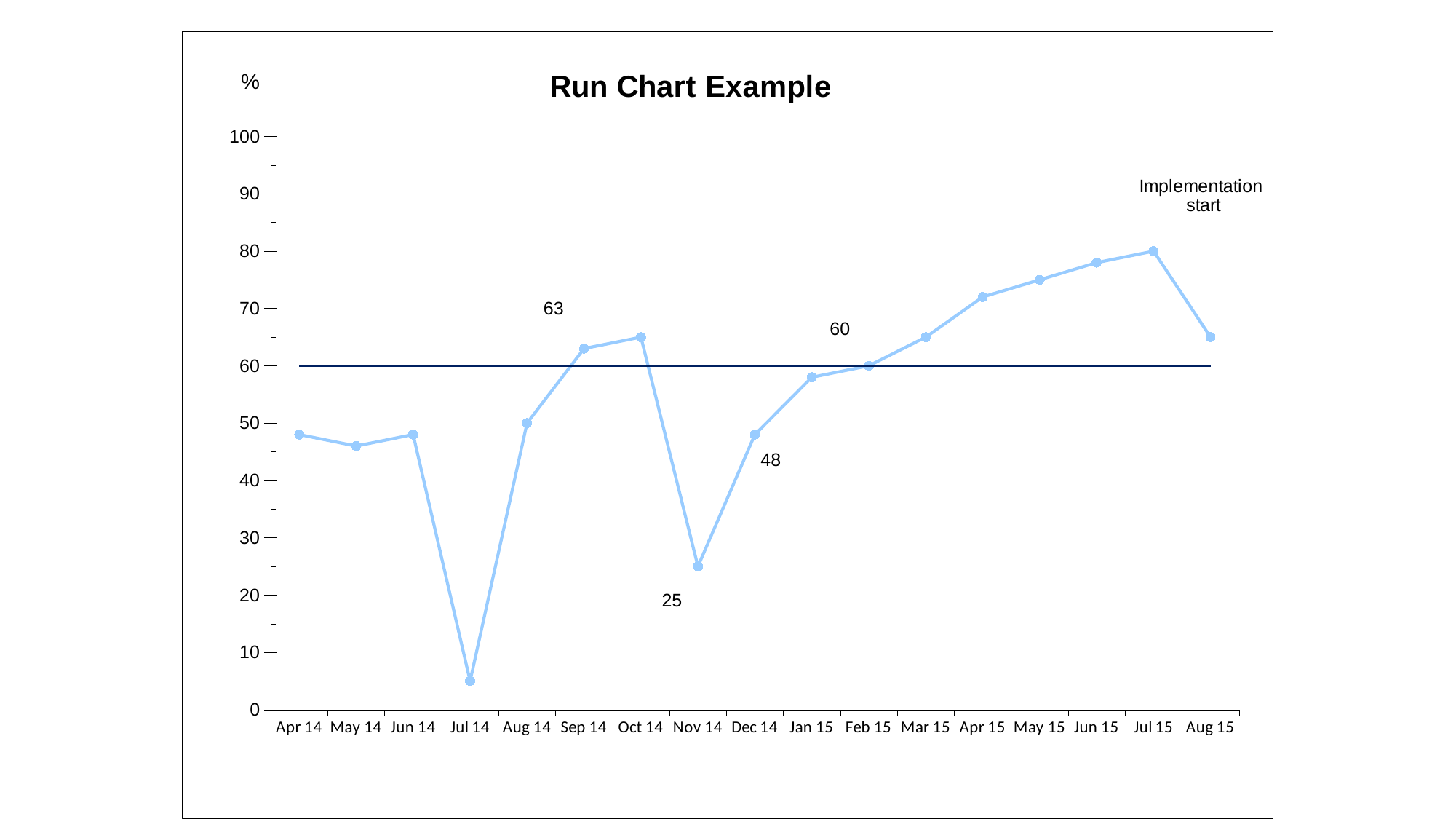
What is the title of the chart? Run Chart Example What is the value for Dec 14? 48 What is the value for Nov 14? 25 Do the values rise or fall from Dec 14 to Jul 15? rise What is the value for Feb 15? 60 What is the value for Sep 14? 63 Which month has the lowest value? Jul 14 Is the value for Jul 14 greater or less than 10? less What is the difference between the values for Sep 14 and Nov 14? 38 Which month has the highest value? Jul 15 How many months are plotted along the x axis? 17 What type of chart is shown on the slide? line chart